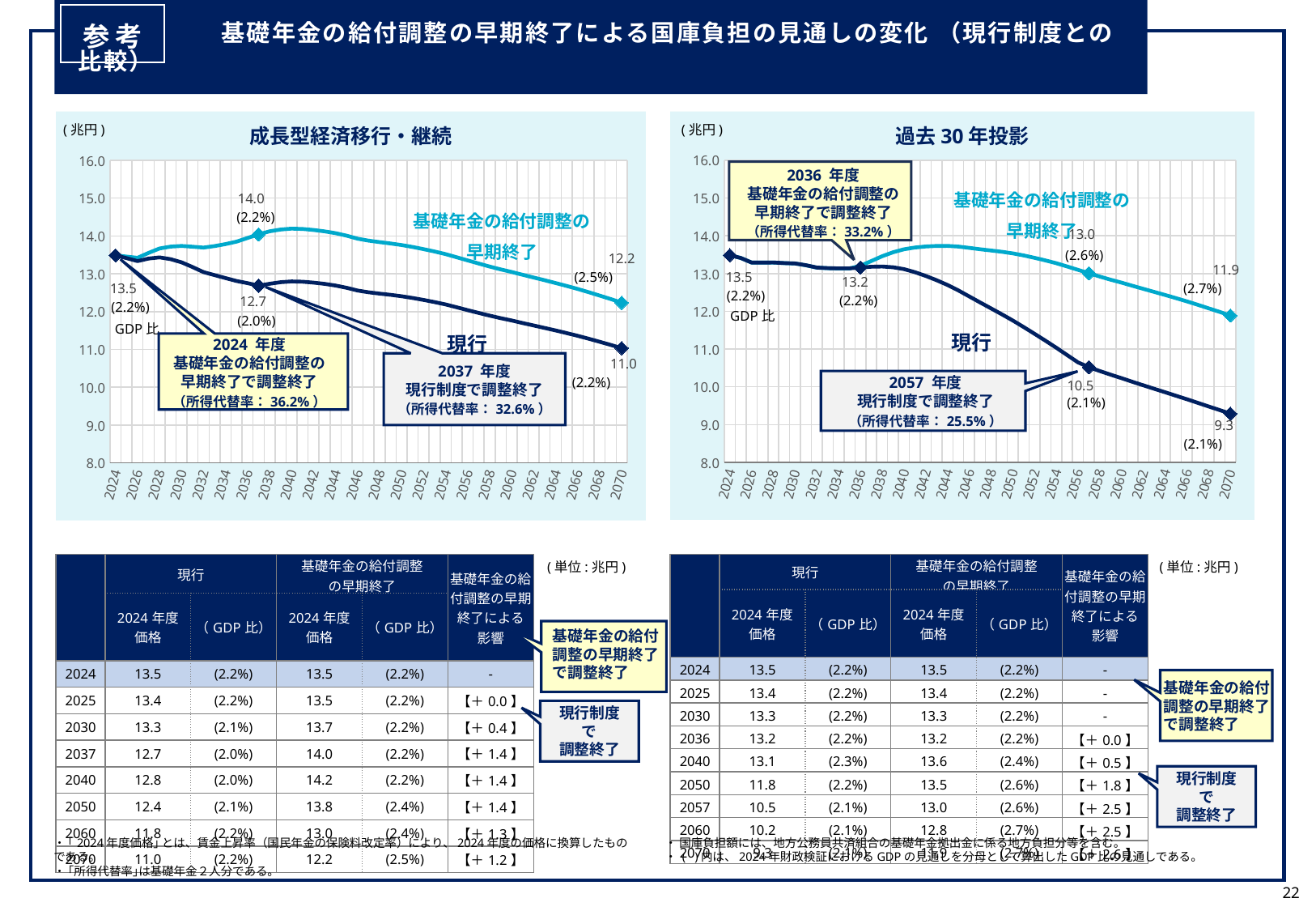
「成長型経済移行・継続」のグラフで、2070年の「基礎年金の給付調整の早期終了」と「現行」の差はいくらですか。 1.2 「成長型経済移行・継続」のグラフで、2070年の「基礎年金の給付調整の早期終了」の値はいくらですか。 12.2 「過去30年投影」のグラフで、2057年の「基礎年金の給付調整の早期終了」の値はいくらですか。 13.0 「過去30年投影」のグラフで、2070年の「現行」の値は10.0より大きいですか、小さいですか。 小さい 「過去30年投影」のグラフには何本の系列が描かれていますか。 2 「過去30年投影」のグラフで、2070年の「現行」の値はいくらですか。 9.3 「過去30年投影」のグラフで、2057年の「基礎年金の給付調整の早期終了」と「現行」の差はいくらですか。 2.5 「成長型経済移行・継続」のグラフで、2037年の「現行」の値はいくらですか。 12.7 「成長型経済移行・継続」のグラフはどの種類のグラフですか。 折れ線グラフ 「過去30年投影」のグラフで、「現行」の値は2024年から2070年にかけて上昇していますか、下降していますか。 下降 「成長型経済移行・継続」のグラフで、2037年時点では「基礎年金の給付調整の早期終了」と「現行」のどちらの値が大きいですか。 基礎年金の給付調整の早期終了 「成長型経済移行・継続」のグラフで、2070年の「現行」の値はいくらですか。 11.0